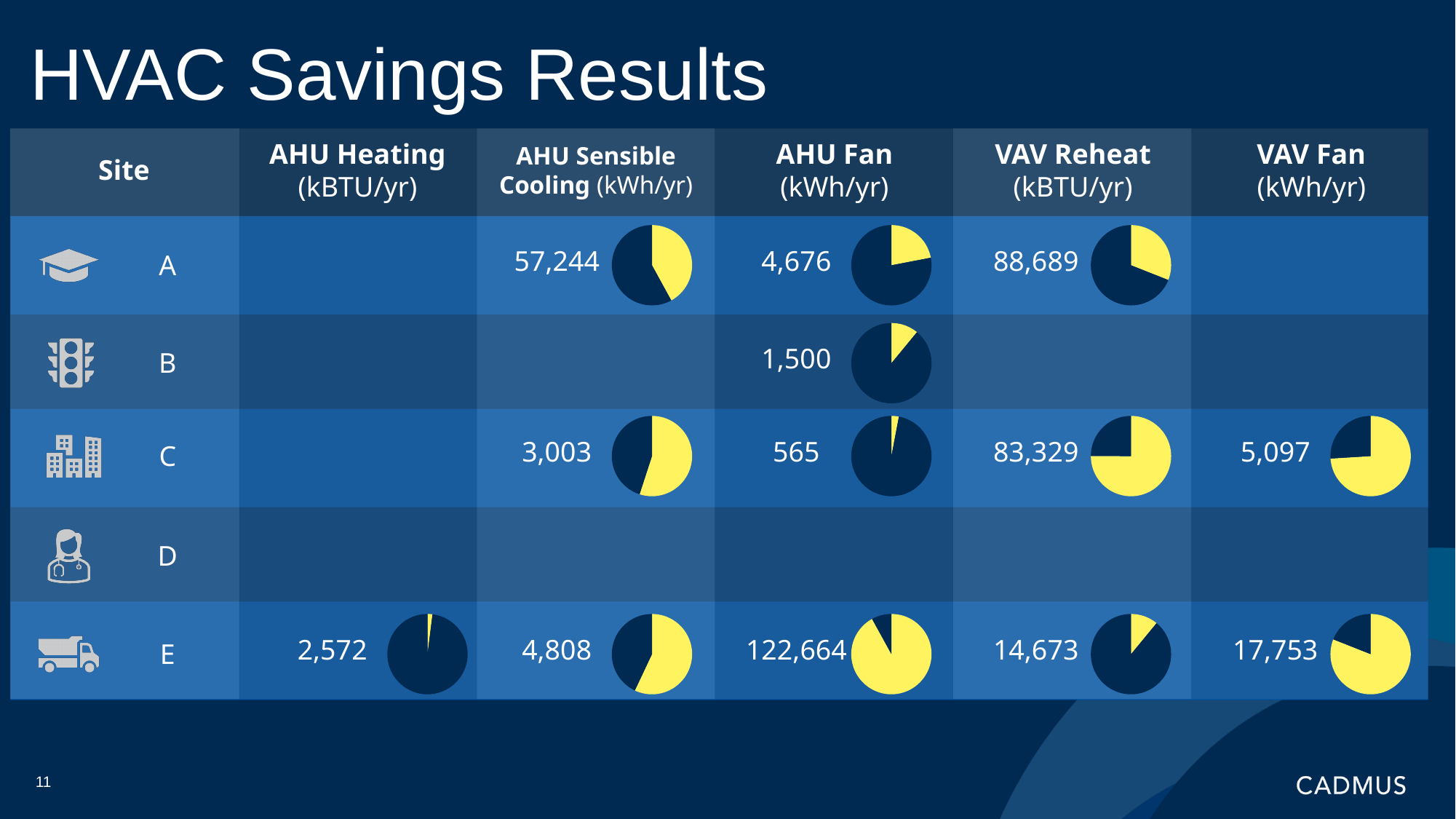
Which site has the larger AHU Sensible Cooling value, Site C or Site E? E What is the VAV Fan value (kWh/yr) for Site C? 5,097 What is the AHU Sensible Cooling value (kWh/yr) for Site A? 57,244 How many sites are listed in the table? 5 Which site is the only one with an AHU Heating value shown? E What kind of chart is shown next to each value in the table? Pie chart What is the difference between the VAV Fan values for Site E and Site C? 12,656 What is the AHU Fan value (kWh/yr) for Site E? 122,664 Which site has the lowest AHU Fan value? C What is the difference between the VAV Reheat values for Site A and Site C? 5,360 Which site has the highest AHU Fan value? E What is the AHU Heating value (kBTU/yr) for Site E? 2,572